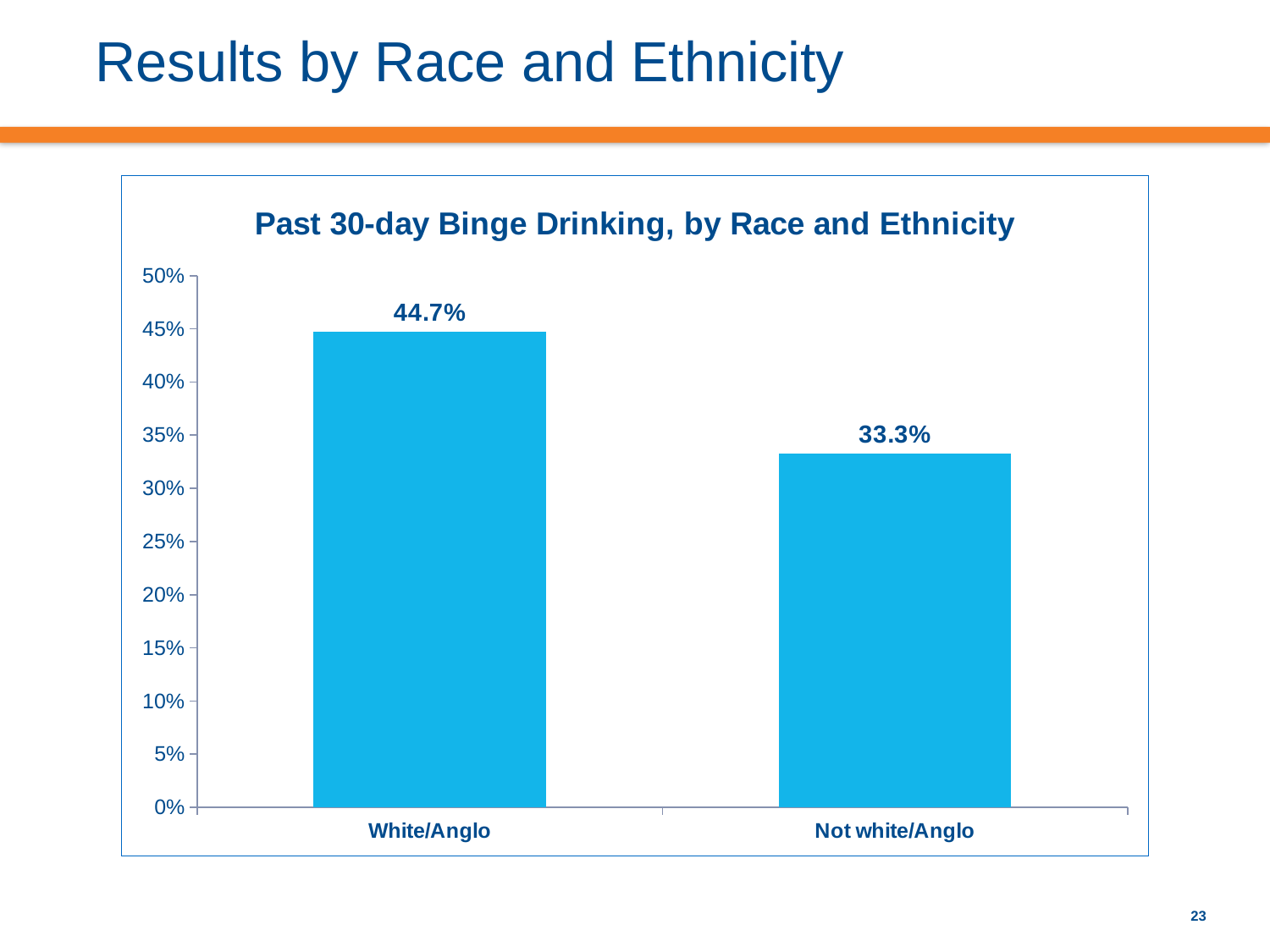
Is the value for White/Anglo greater or less than 40%? greater What kind of chart is shown on the slide? Bar chart Which category has the lowest past 30-day binge drinking rate? Not white/Anglo What is the past 30-day binge drinking rate for Not white/Anglo? 33.3% How many categories are shown on the chart? 2 Which is larger, the binge drinking rate for White/Anglo or for Not white/Anglo? White/Anglo What is the maximum value shown on the vertical axis? 50% Is the value for Not white/Anglo greater or less than 35%? less What is the past 30-day binge drinking rate for White/Anglo? 44.7% Which category has the highest past 30-day binge drinking rate? White/Anglo What is the title of the chart? Past 30-day Binge Drinking, by Race and Ethnicity What is the difference in percentage points between the White/Anglo and Not white/Anglo binge drinking rates? 11.4 percentage points